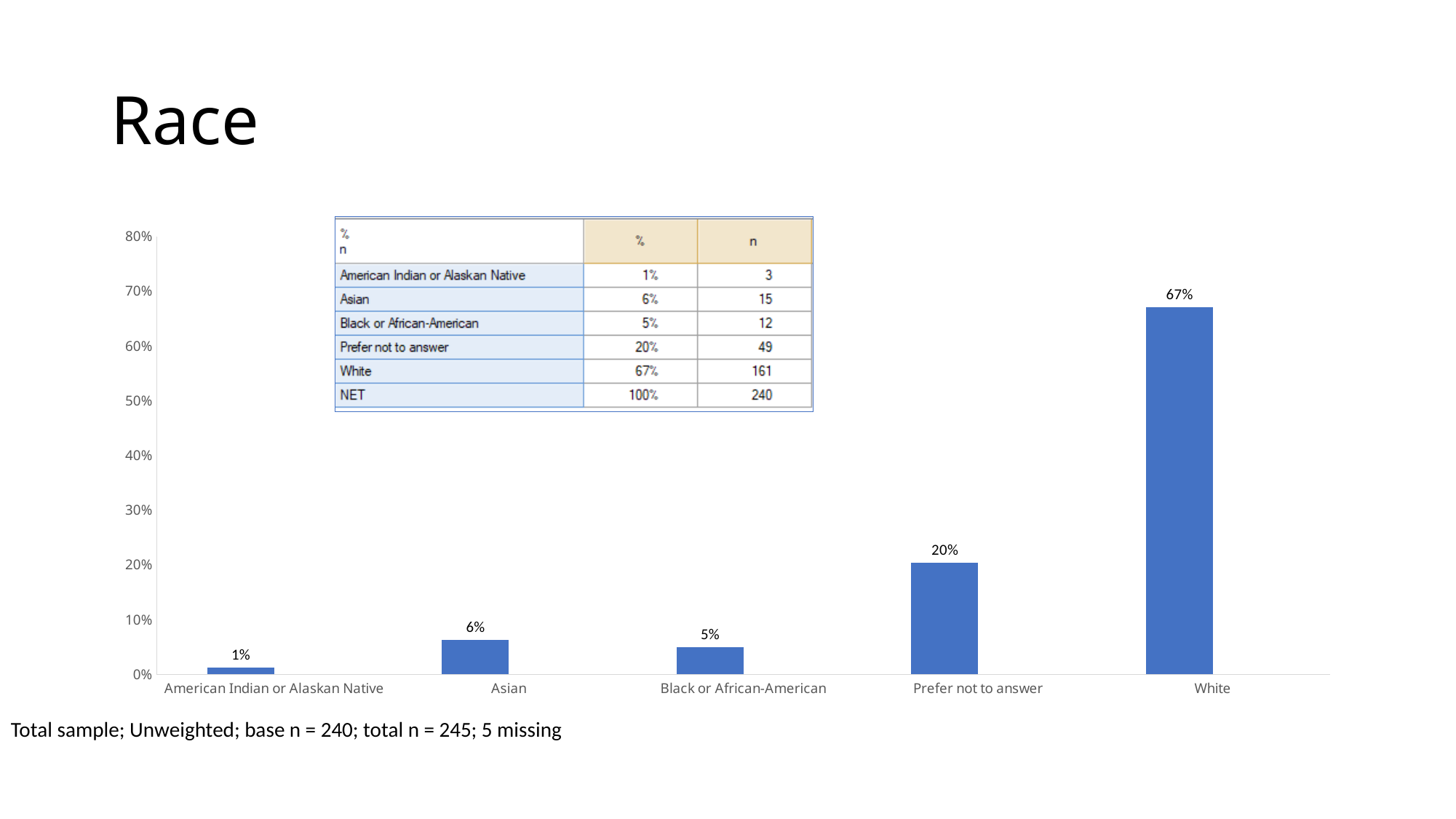
Which is larger, the value for Asian or the value for Black or African-American? Asian What kind of chart is shown on the slide? bar chart What is the title of the slide? Race How many categories are shown on the x axis? 5 Is the value for White greater or less than 60%? greater What is the value for White? 67% What is the value for Black or African-American? 5% Which category has the highest value? White What is the difference between the values for White and Prefer not to answer? 47% Which category has the lowest value? American Indian or Alaskan Native What is the value for Asian? 6% What is the value for Prefer not to answer? 20%